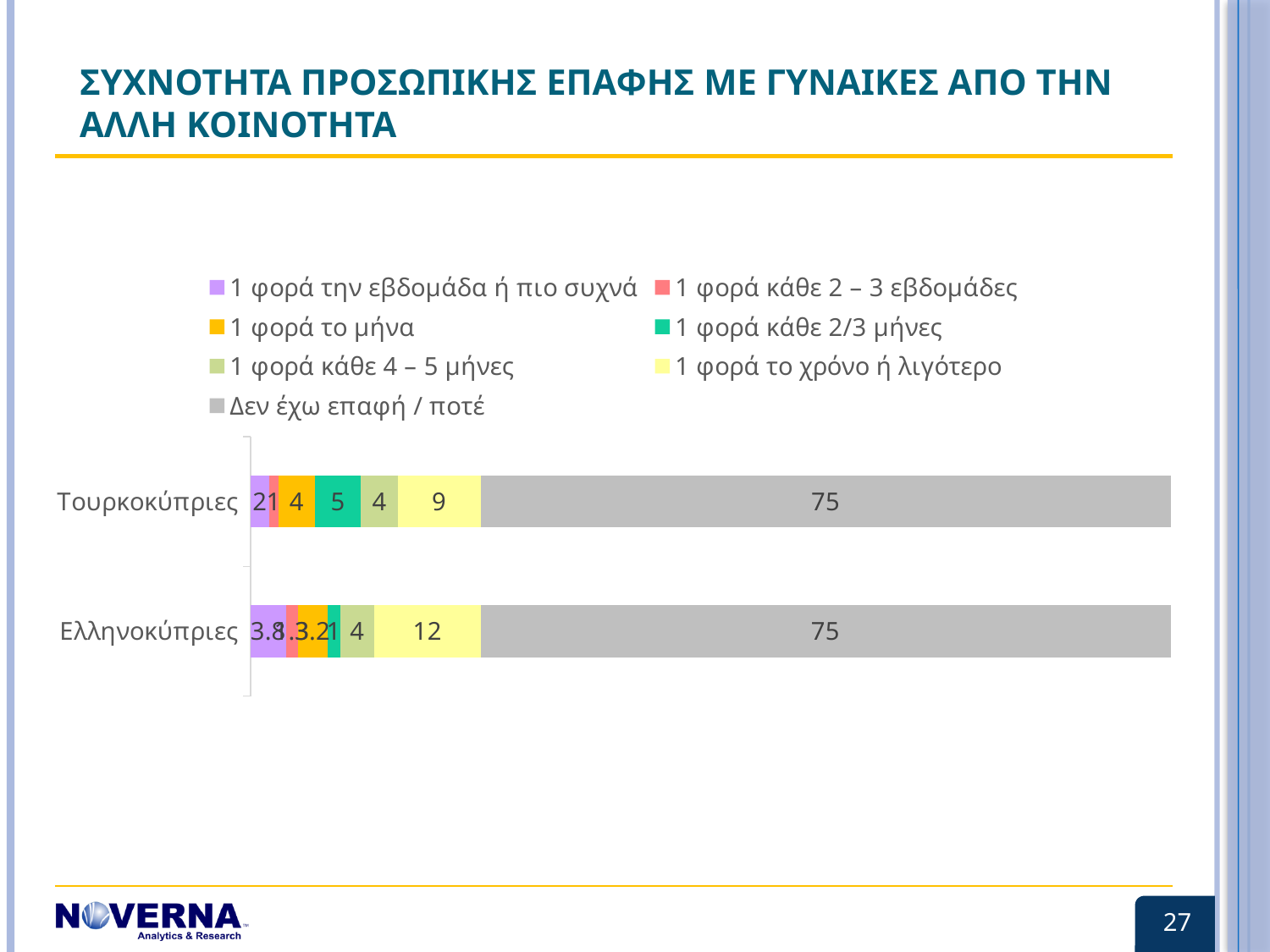
What is the difference between the '1 φορά το χρόνο ή λιγότερο' values for Ελληνοκύπριες and Τουρκοκύπριες? 3 What is the value of '1 φορά κάθε 4 – 5 μήνες' for Ελληνοκύπριες? 4 What is the value of '1 φορά το χρόνο ή λιγότερο' for Τουρκοκύπριες? 9 What is the value of 'Δεν έχω επαφή / ποτέ' for Τουρκοκύπριες? 75 Which category has the larger value for '1 φορά το χρόνο ή λιγότερο', Τουρκοκύπριες or Ελληνοκύπριες? Ελληνοκύπριες What is the value of 'Δεν έχω επαφή / ποτέ' for Ελληνοκύπριες? 75 Which series has the largest segment in the Τουρκοκύπριες bar? Δεν έχω επαφή / ποτέ What is the value of '1 φορά κάθε 2/3 μήνες' for Τουρκοκύπριες? 5 How many categories (bars) are plotted in the chart? 2 How many series does the legend list? 7 What is the value of '1 φορά το χρόνο ή λιγότερο' for Ελληνοκύπριες? 12 What kind of chart is shown on the slide? stacked bar chart